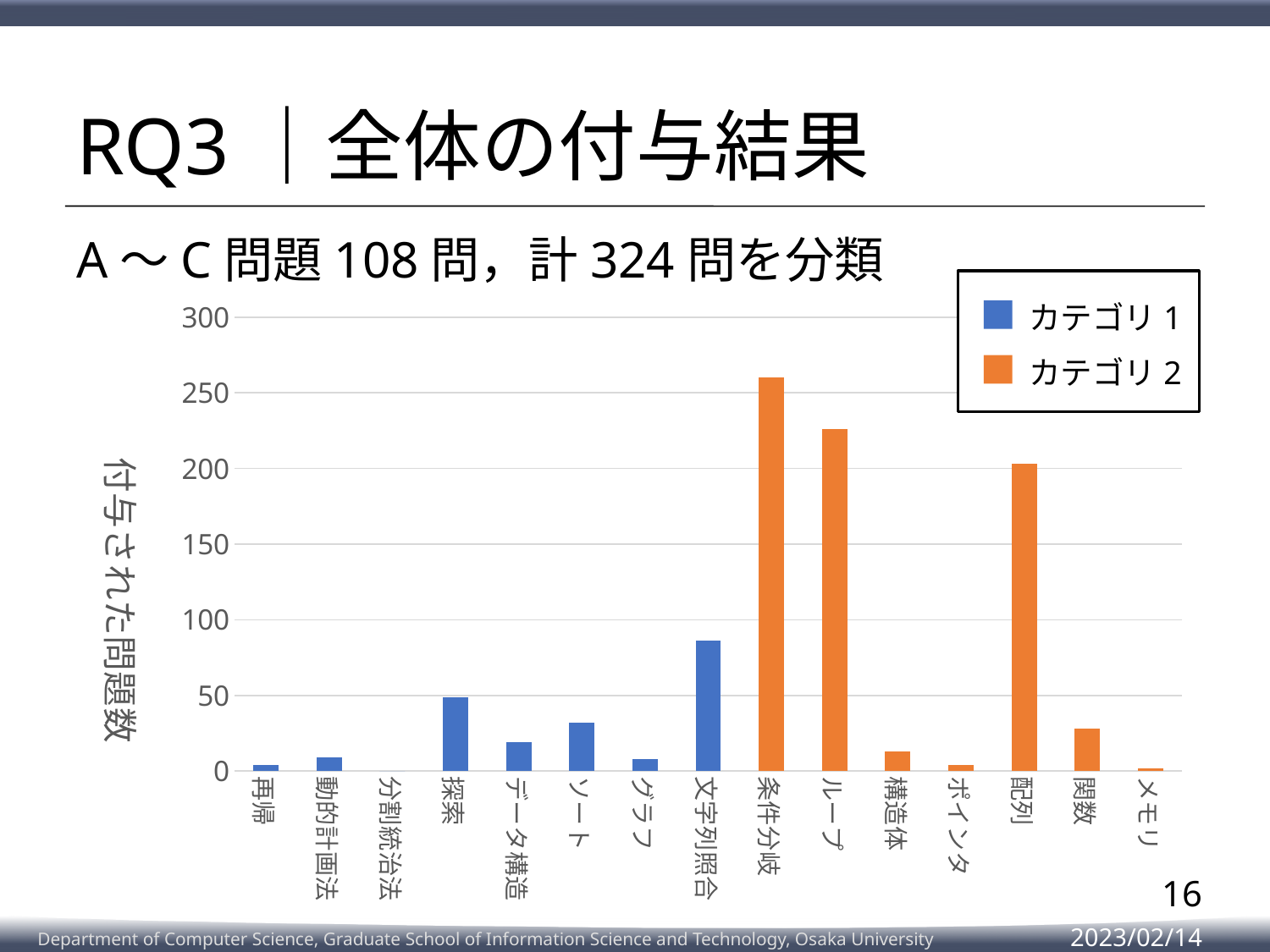
How many series does the chart legend list? 2 What kind of chart is shown on the slide? bar chart Is the value for ループ greater or less than 200? greater Is the value for 文字列照合 greater or less than 100? less What is the label of the vertical axis of the chart? 付与された問題数 Is the value for 条件分岐 greater or less than 250? greater Which category has the highest bar in the chart? 条件分岐 Which is larger, the value for 探索 or the value for ソート? 探索 What are the two series names listed in the chart legend? カテゴリ 1, カテゴリ 2 How many categories are shown on the x axis of the chart? 15 Which is larger, the value for 配列 or the value for ループ? ループ